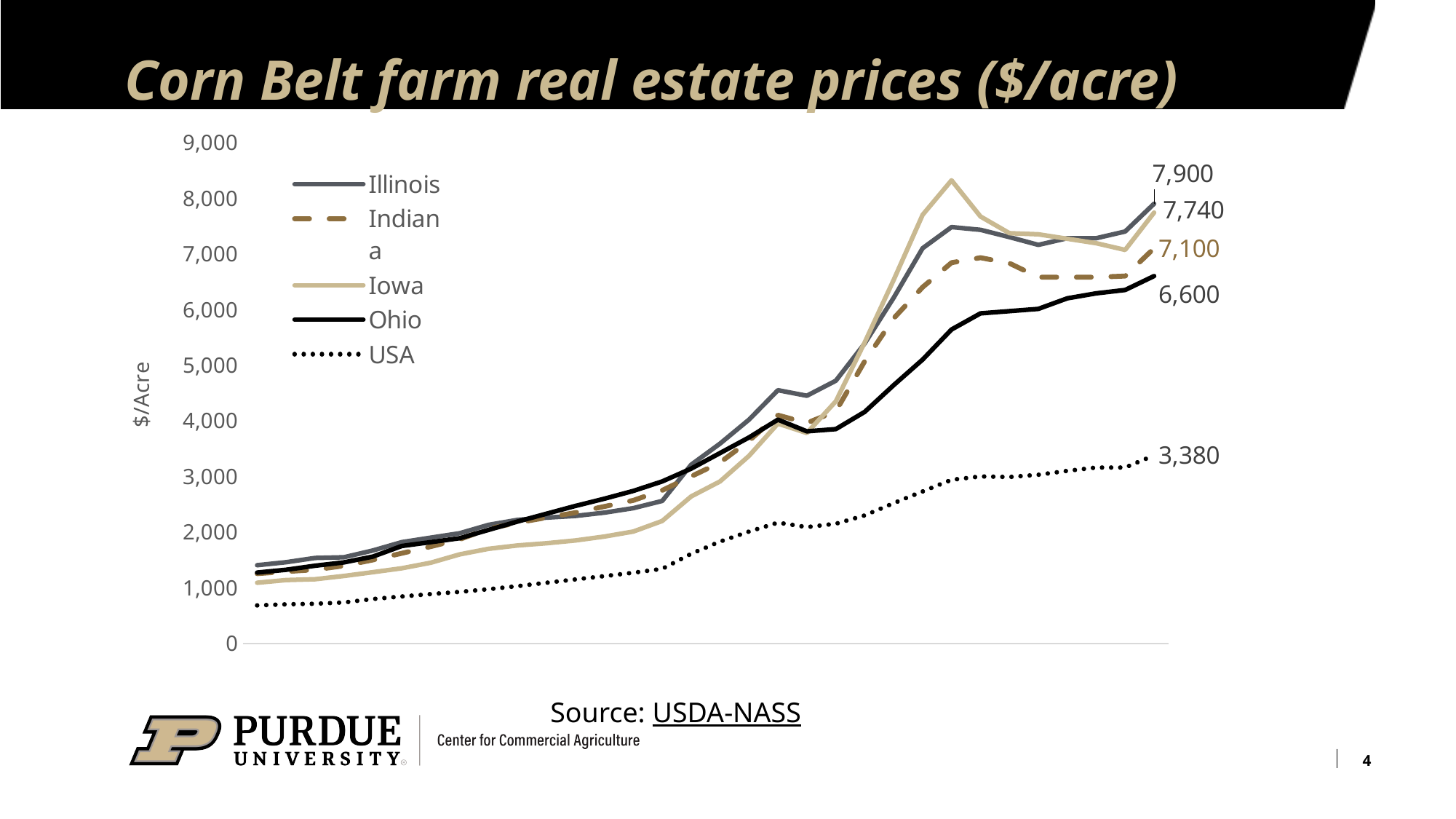
Do the values for the USA series generally rise or fall along the x axis? rise Which series has the highest value at the end of the chart? Illinois What type of chart is shown on the slide? line chart Which series has the lowest value at the end of the chart? USA What is the final labelled value for Illinois? 7,900 What is the label on the vertical axis? $/Acre What is the final labelled value for Iowa? 7,740 What is the final labelled value for Indiana? 7,100 How many series does the legend list? 5 What is the final labelled value for Ohio? 6,600 What is the difference between the final values for Illinois and Ohio? 1,300 What is the final labelled value for USA? 3,380